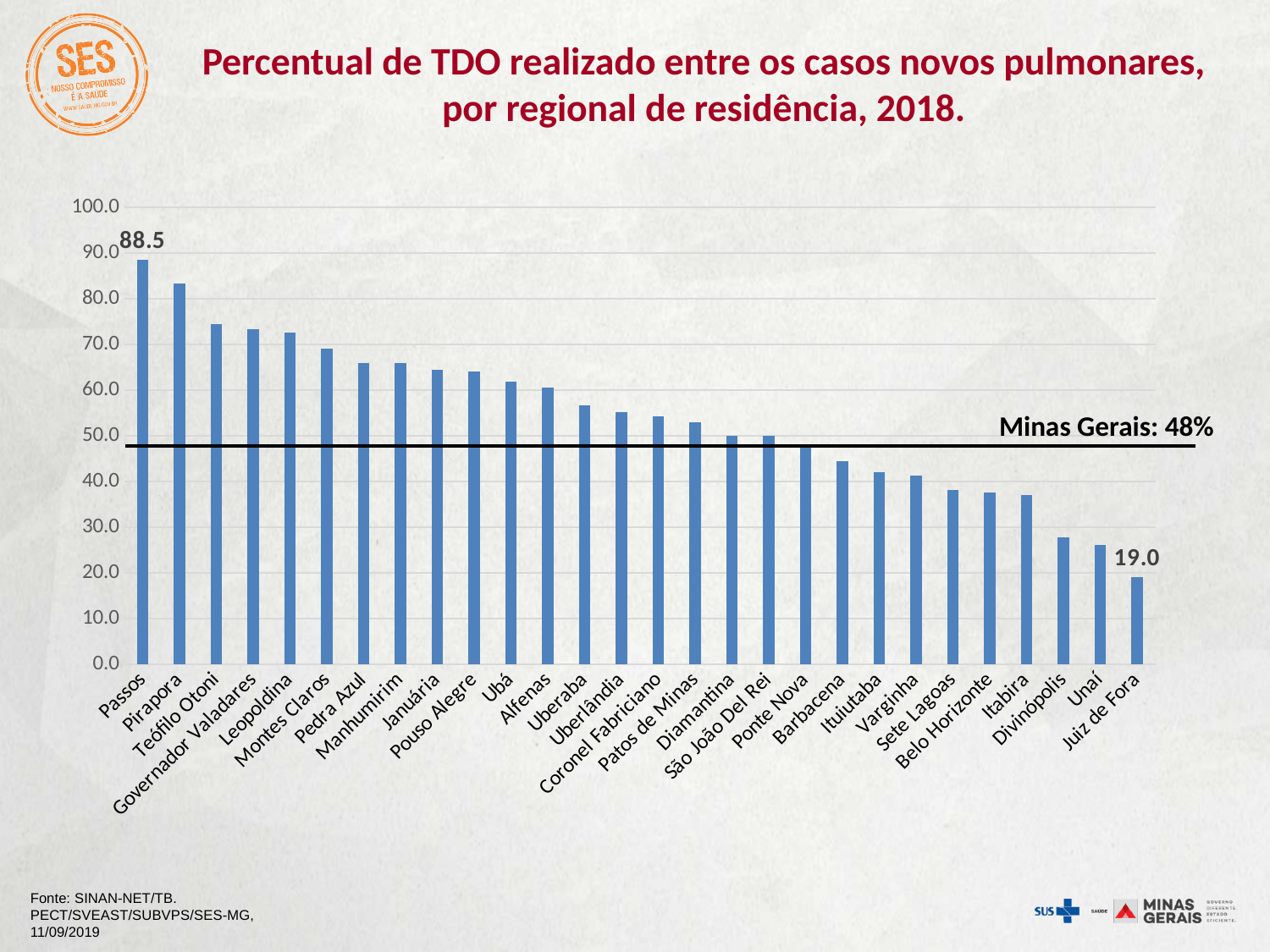
Which regional has the highest percentage? Passos Which regional has the lowest percentage? Juiz de Fora What kind of chart is shown on the slide? Bar chart Is the value for Belo Horizonte greater or less than 40? less What is the difference between the values for Passos and Juiz de Fora? 69.5 Which is larger, the value for Pirapora or the value for Belo Horizonte? Pirapora Is the value for Pirapora greater or less than 80? greater How many regionals are shown on the x axis? 28 What value does the horizontal reference line labelled Minas Gerais represent? 48% What is the value for Passos? 88.5 What is the value for Juiz de Fora? 19.0 Is the value for Divinópolis greater or less than 30? less